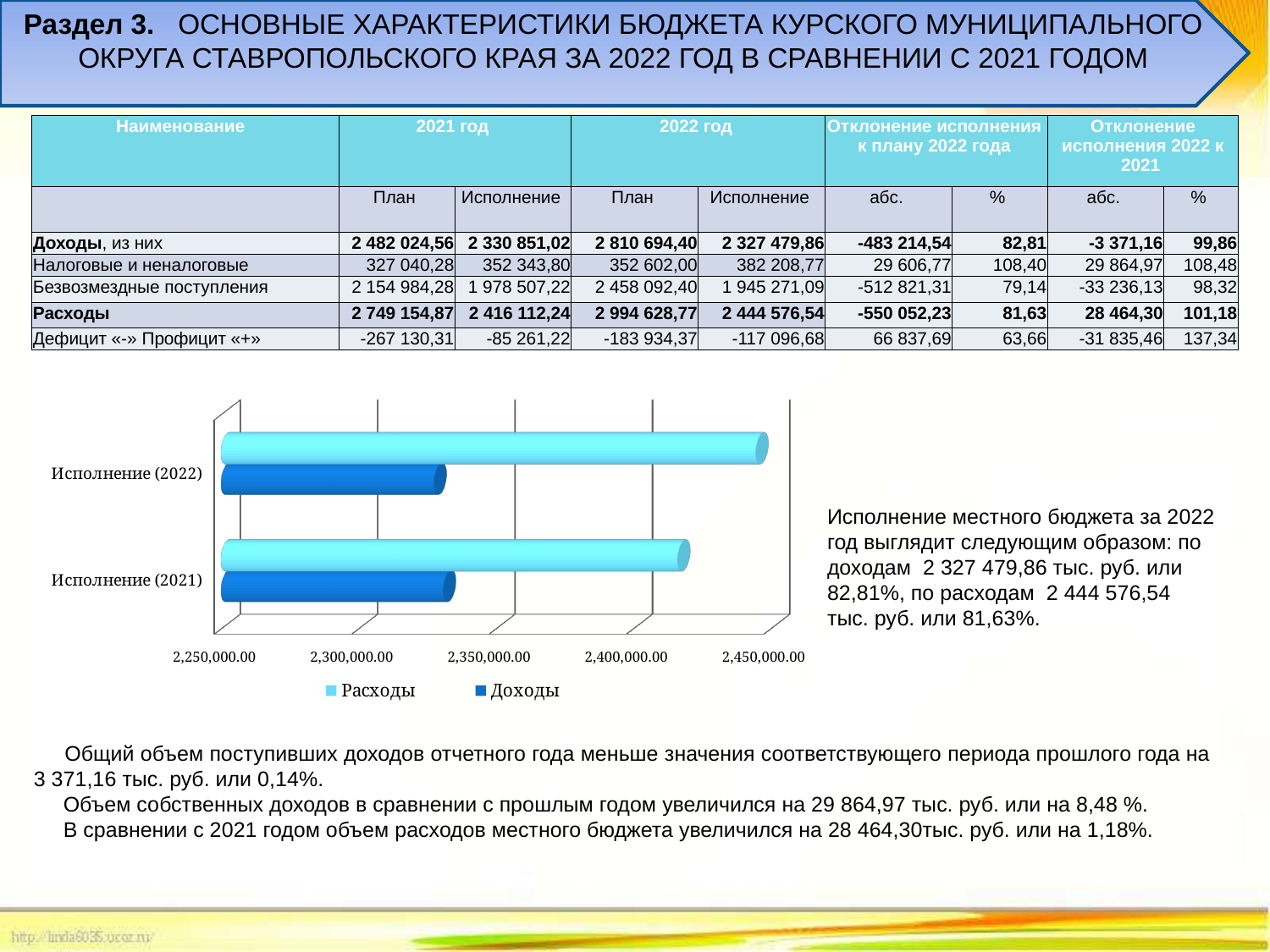
What kind of chart is shown on the slide? bar chart How many series does the chart legend list? 2 Is the value of Доходы for Исполнение (2021) greater or less than 2,300,000.00? greater Which series is shown in light blue in the chart legend? Расходы Is the value of Расходы for Исполнение (2022) greater or less than 2,400,000.00? greater Which is larger for Расходы: Исполнение (2022) or Исполнение (2021)? Исполнение (2022) Is the value of Доходы for Исполнение (2022) greater or less than 2,350,000.00? less How many categories are shown on the vertical axis of the chart? 2 Which is larger for Исполнение (2022): Расходы or Доходы? Расходы What is the leftmost tick value on the horizontal axis of the chart? 2,250,000.00 Which bar in the chart is the longest? Расходы, Исполнение (2022)